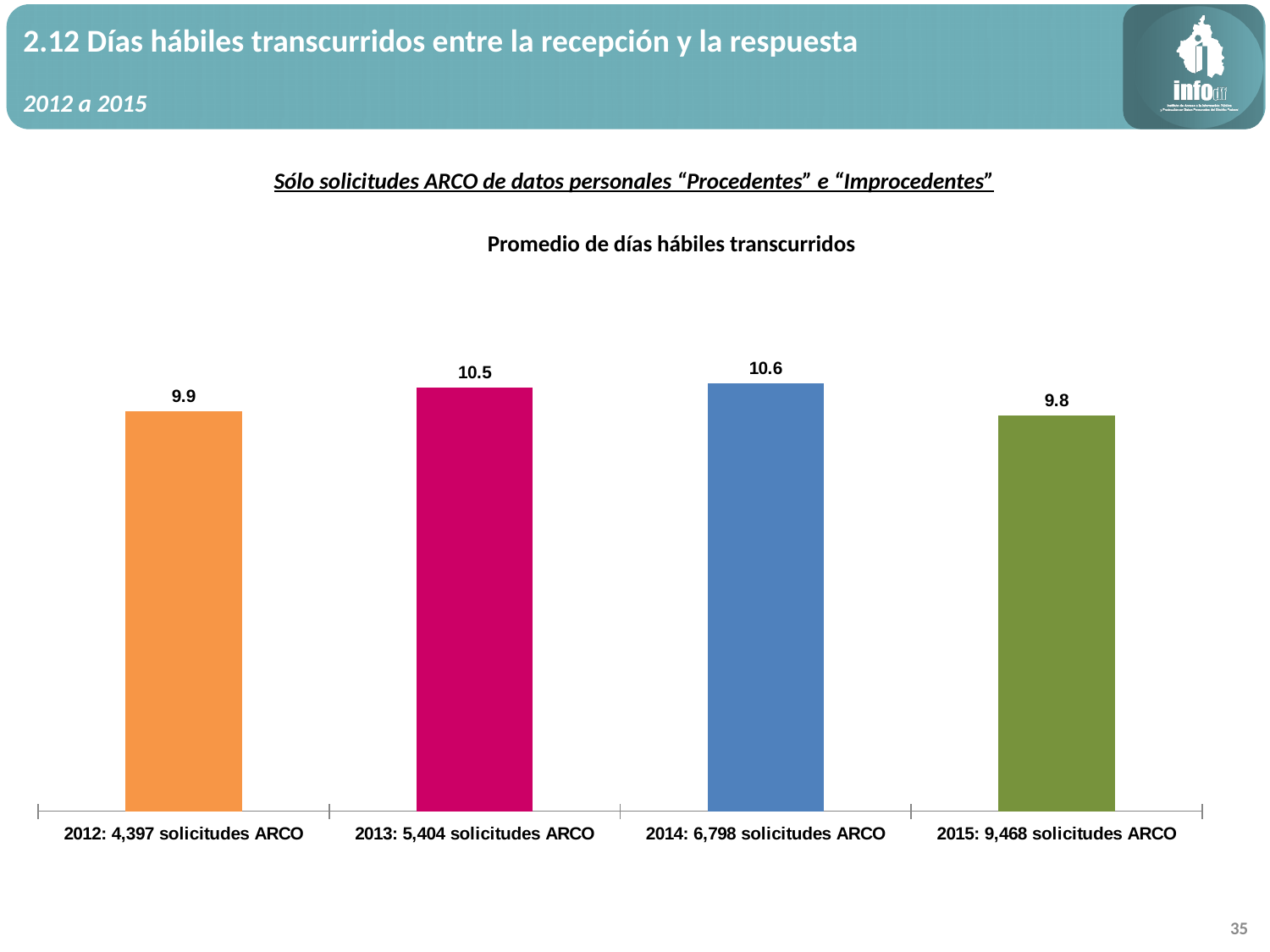
What is the difference between the values for 2014 and 2012? 0.7 How many years (bars) are shown in the chart? 4 What is the average number of business days shown for 2014? 10.6 What is the value shown for 2015? 9.8 What is the title of the chart? Promedio de días hábiles transcurridos Which is larger, the value for 2013 or the value for 2015? 2013 What kind of chart is shown on the slide? Bar chart What is the average number of business days (promedio de días hábiles transcurridos) for 2012? 9.9 What is the difference between the values for 2013 and 2015? 0.7 Which year has the highest average number of business days? 2014 How many solicitudes ARCO are indicated in the axis label for 2015? 9,468 Which year has the lowest average number of business days? 2015